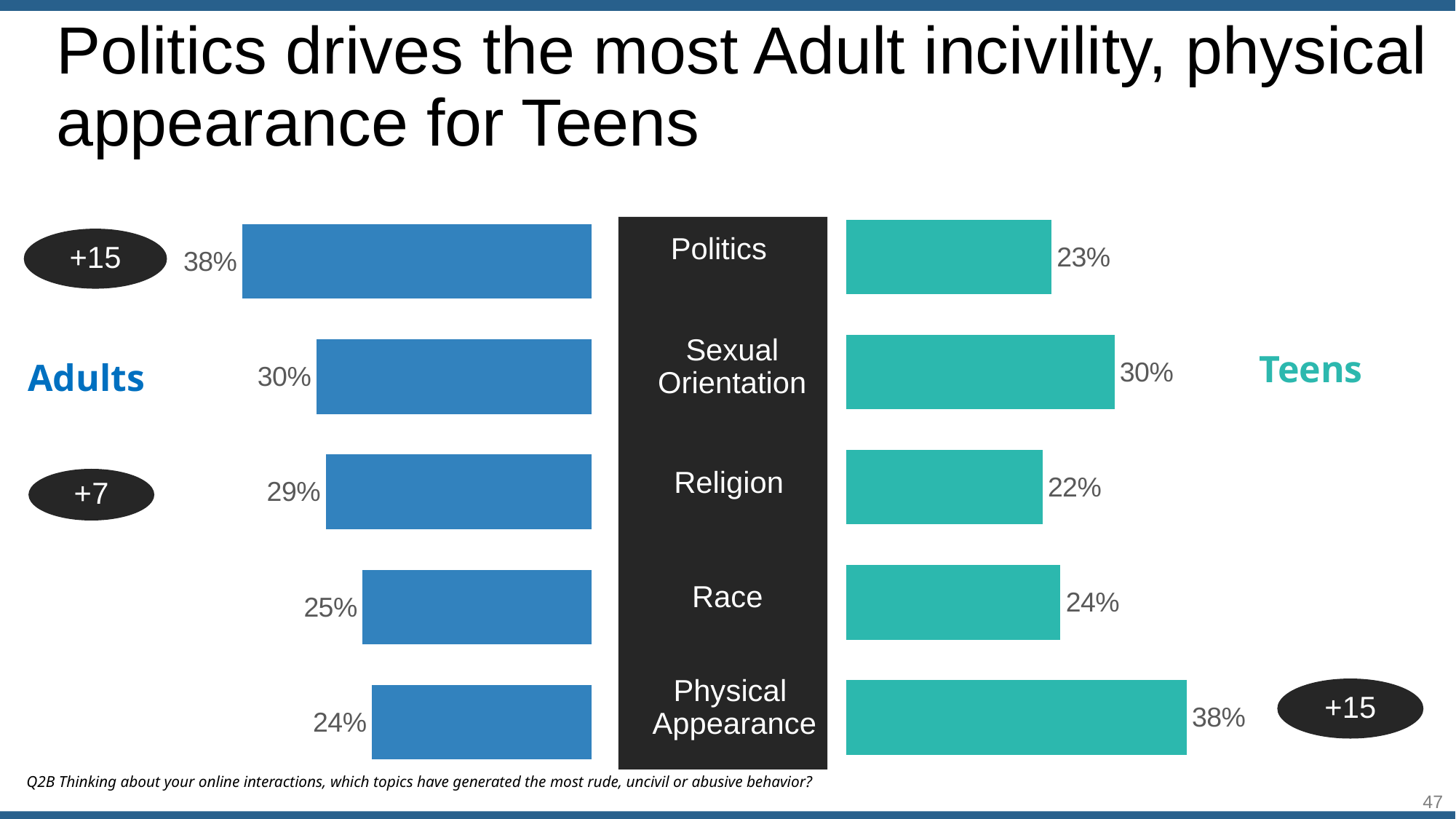
What is the Teens value for Religion? 22% What percentage of Teens cite Physical Appearance? 38% What is the difference between the Adults and Teens values for Politics? 15 How many topics are shown in the chart? 5 What is the Adults value for Race? 25% What percentage of Adults cite Politics as a topic generating uncivil behavior? 38% Which topic has the highest value for Adults? Politics What type of chart is shown on the slide? Bar chart Which topic has the lowest value for Teens? Religion How many groups (series) are compared in the chart? 2 What is the difference between the Adults and Teens values for Religion? 7 Which is larger for Race: the Adults value or the Teens value? Adults